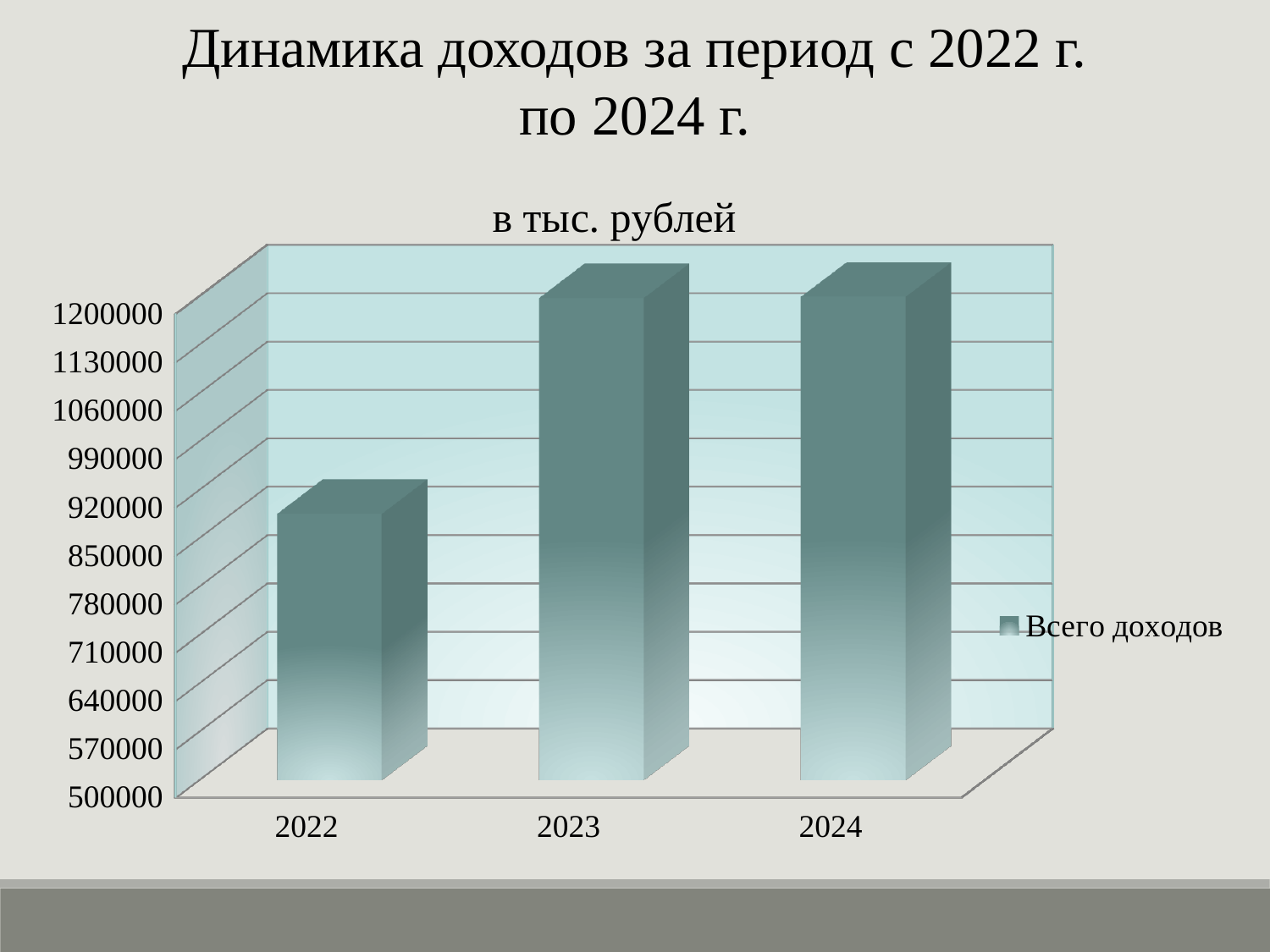
What kind of chart is shown on the slide? bar chart Is the value for 2022 greater or less than 990000? less Is the value for 2022 greater or less than 850000? greater Is the value for 2023 greater or less than 1130000? greater What is the name of the series shown in the legend? Всего доходов Which is larger, the value for 2022 or the value for 2023? 2023 How many years (categories) are plotted on the chart? 3 Does the value rise or fall from 2022 to 2023? rise What unit is stated in the chart title? в тыс. рублей Which year has the lowest value on the chart? 2022 How many series does the legend list? 1